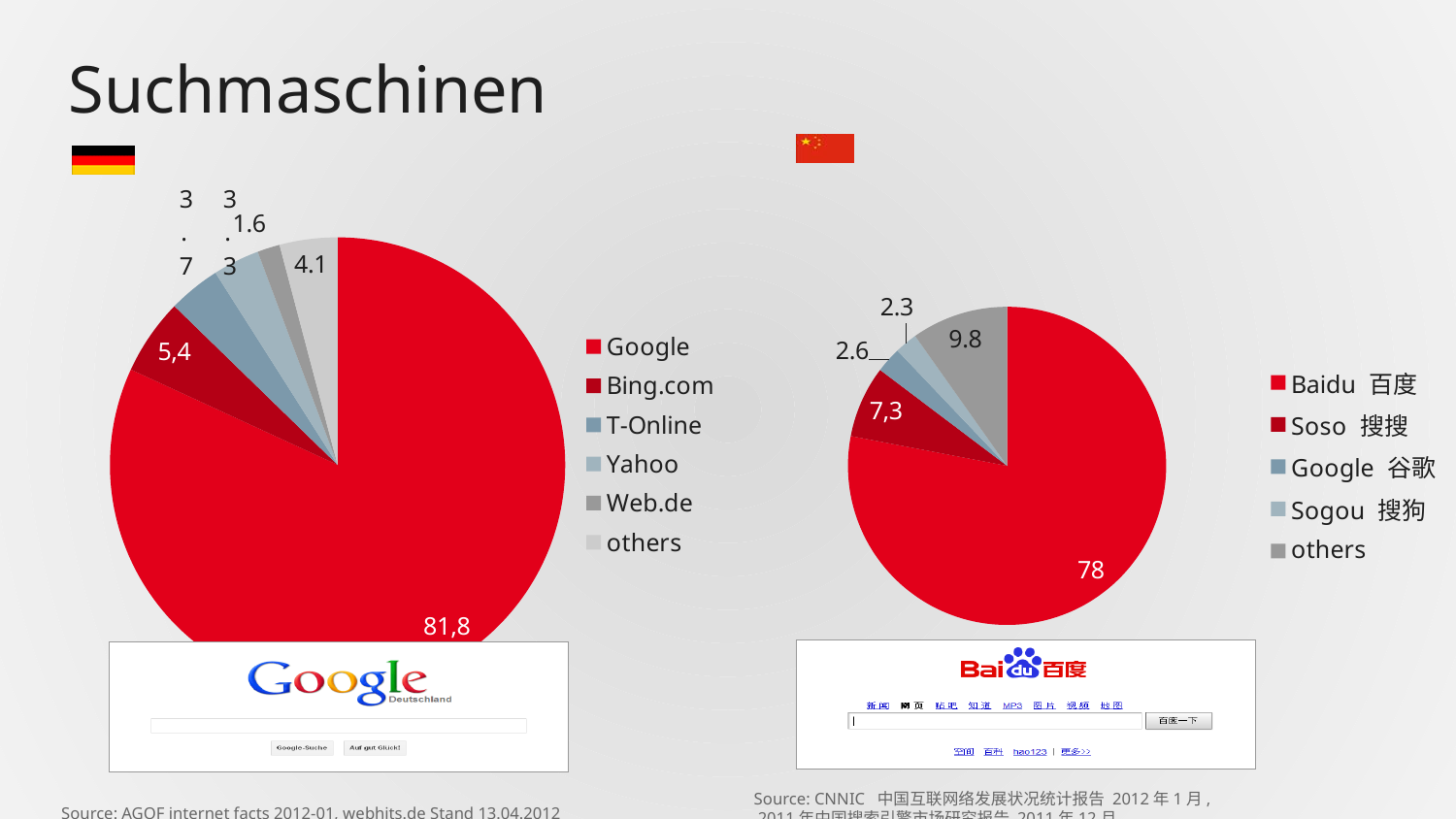
How many entries does the legend of the left pie chart (Germany) list? 6 In the right pie chart (China), what is the value for Baidu? 78 In the right pie chart (China), what is the value for others? 9.8 How many entries does the legend of the right pie chart (China) list? 5 In the left pie chart (Germany), what is the value for others? 4.1 In the right pie chart (China), which search engine has the largest share? Baidu In the left pie chart (Germany), which search engine has the largest share? Google In the left pie chart (Germany), what is the value for Bing.com? 5,4 In the left pie chart (Germany), what is the value for Google? 81,8 In the right pie chart (China), which is larger, the value for Google or the value for Sogou? Google What kind of chart is shown on the left side of the slide? pie chart In the right pie chart (China), what is the value for Soso? 7,3